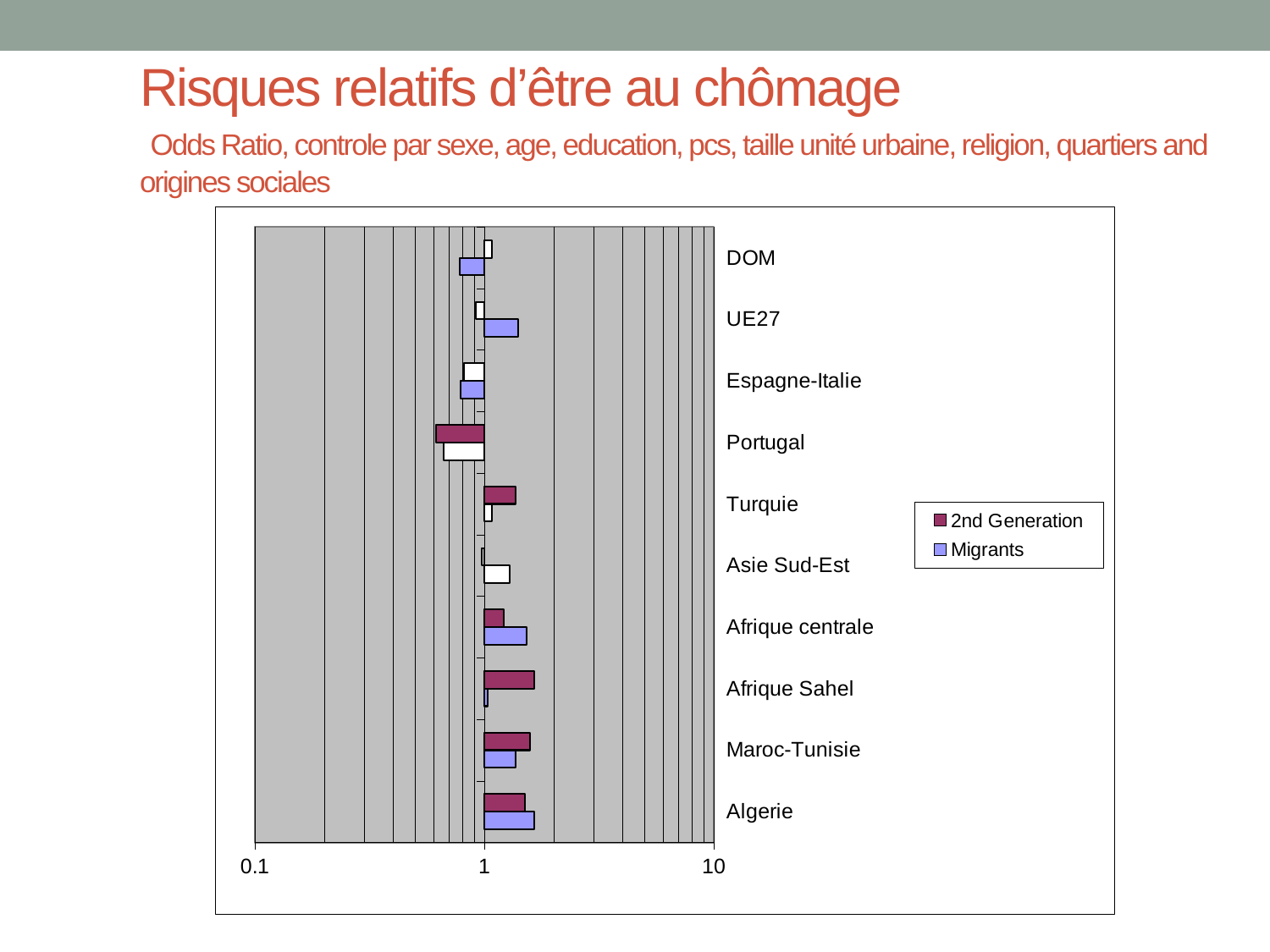
What are the lowest and highest values shown on the horizontal axis? 0.1 and 10 For Afrique Sahel, which is larger: the 2nd Generation value or the Migrants value? 2nd Generation What are the two series named in the legend? 2nd Generation and Migrants Is the 2nd Generation value for Portugal greater or less than 1? less How many categories (origin groups) are listed on the chart? 10 How many series does the legend list? 2 Is the 2nd Generation value for Afrique Sahel greater or less than 1? greater Which category has the lowest 2nd Generation value? Portugal Is the Migrants value for Espagne-Italie greater or less than 1? less Which is larger: the 2nd Generation value for Algerie or the 2nd Generation value for Portugal? Algerie What kind of chart is shown on the slide? bar chart